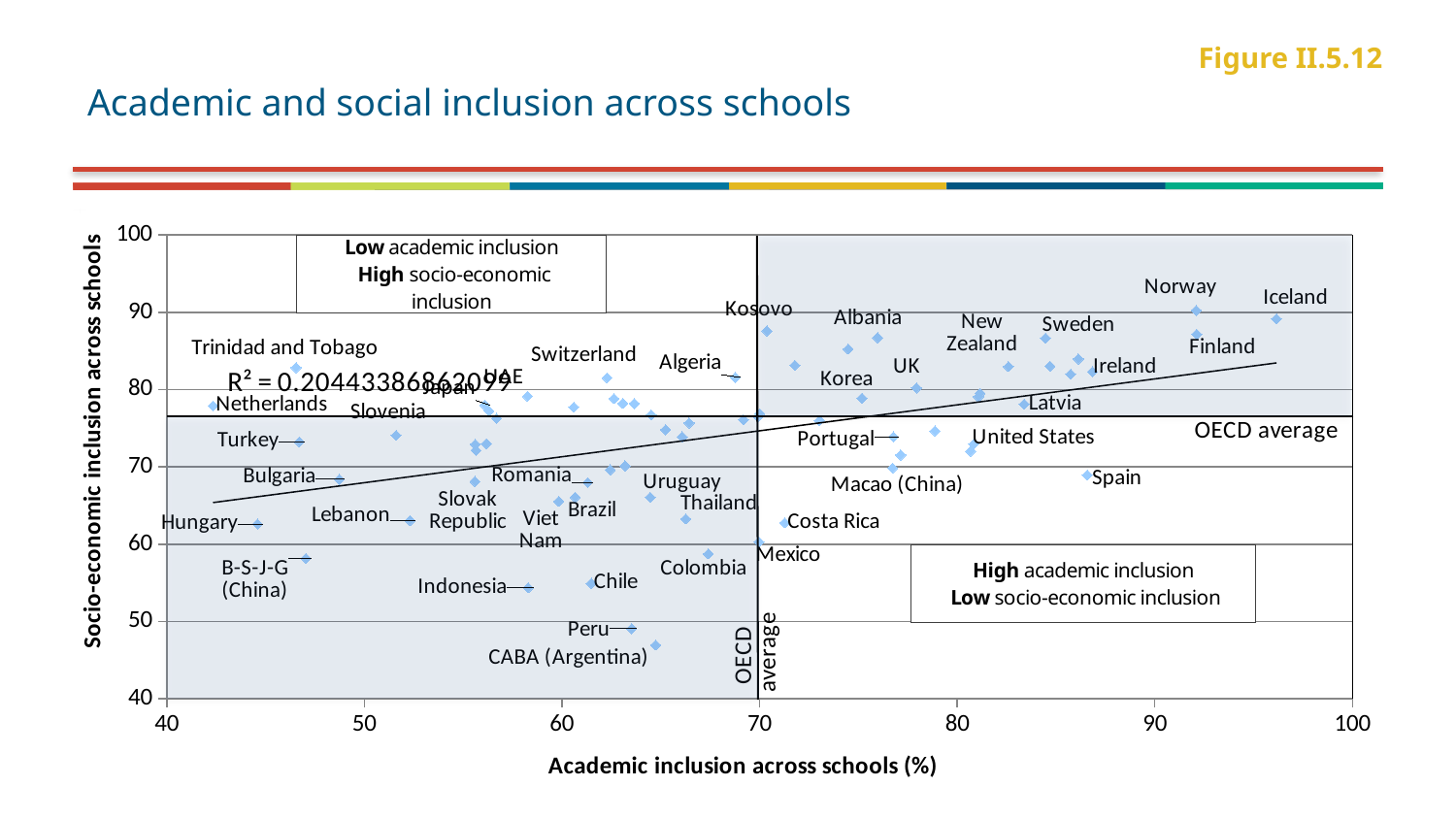
Is the socio-economic inclusion value for Indonesia greater or less than 60? less What kind of chart is shown on the slide? scatter chart Is the academic inclusion value for Spain greater or less than 80? greater Which labelled country has the highest academic inclusion across schools? Iceland Does the fitted trend line rise or fall as academic inclusion increases? rises What is the R² value printed on the chart? 0.204433868620799 Which has the higher socio-economic inclusion across schools, Norway or Peru? Norway Is the socio-economic inclusion value for Kosovo greater or less than 80? greater What is the title of the chart? Academic and social inclusion across schools Which has the higher academic inclusion across schools, Iceland or Hungary? Iceland